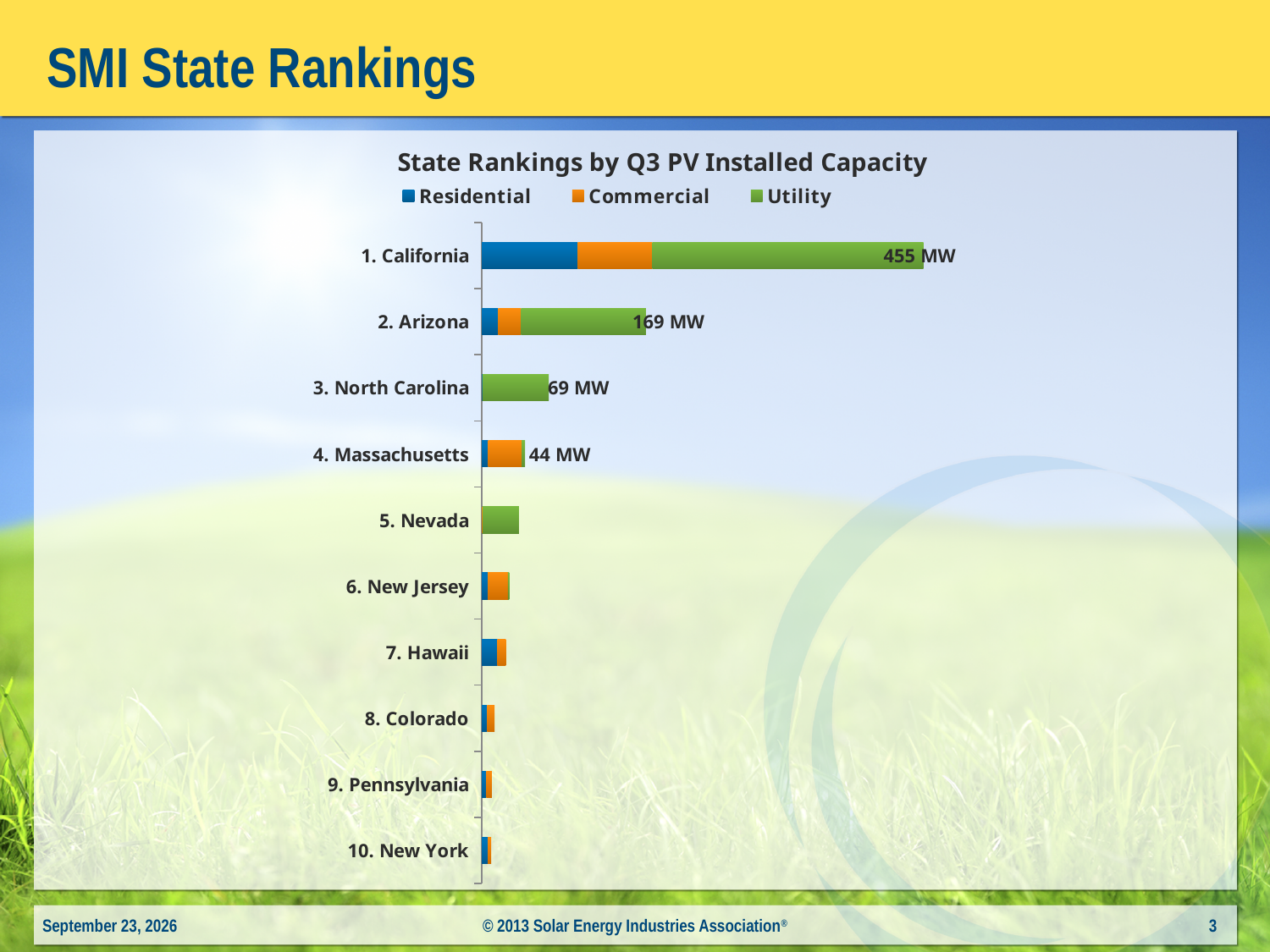
Which state has the lowest Q3 PV installed capacity? New York What is the total Q3 PV installed capacity labelled for Arizona? 169 MW How many series does the legend list? 3 Which state has the highest Q3 PV installed capacity? California What is the total Q3 PV installed capacity labelled for California? 455 MW What is the difference between California's and Arizona's labelled capacities? 286 MW What is the title of the chart? State Rankings by Q3 PV Installed Capacity What is the total Q3 PV installed capacity labelled for Massachusetts? 44 MW How many states are shown in the chart? 10 What kind of chart is shown on the slide? Stacked bar chart What is the total Q3 PV installed capacity labelled for North Carolina? 69 MW Which series is shown in green in the legend? Utility